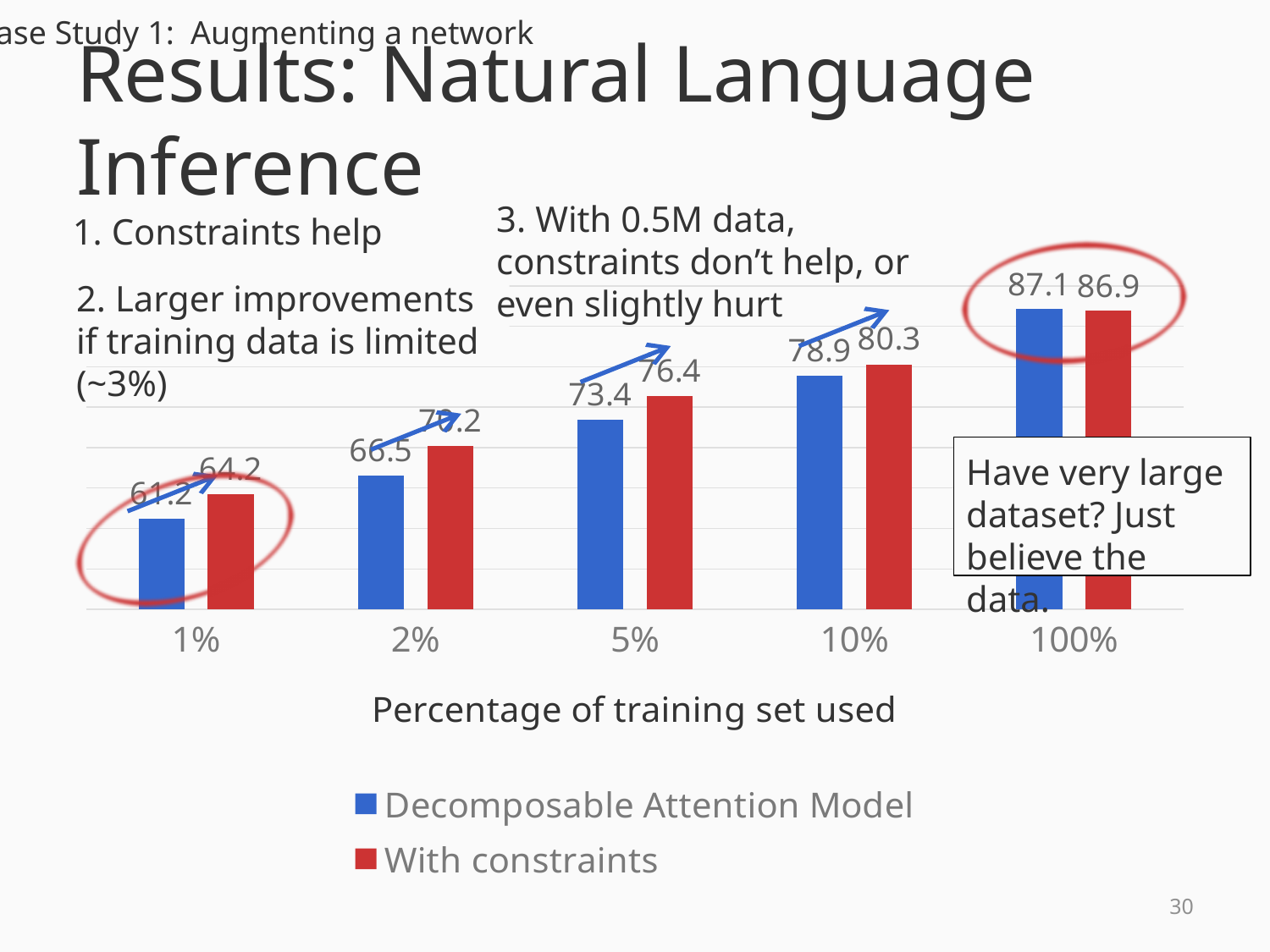
What kind of chart is shown on the slide? bar chart What is the difference between the With constraints value and the Decomposable Attention Model value at 1% of the training set? 3 At 100% of the training set, which series has the larger value: Decomposable Attention Model or With constraints? Decomposable Attention Model What is the value for With constraints at 5% of the training set? 76.4 What is the value for the Decomposable Attention Model at 100% of the training set? 87.1 At which training-set percentage is the Decomposable Attention Model value lowest? 1% What is the x-axis title of the chart? Percentage of training set used How many series does the legend list? 2 How many training-set percentage categories are shown on the x axis? 5 What is the value for the Decomposable Attention Model at 1% of the training set? 61.2 What is the value for With constraints at 10% of the training set? 80.3 Do the Decomposable Attention Model values rise or fall as the percentage of training set used increases? rise